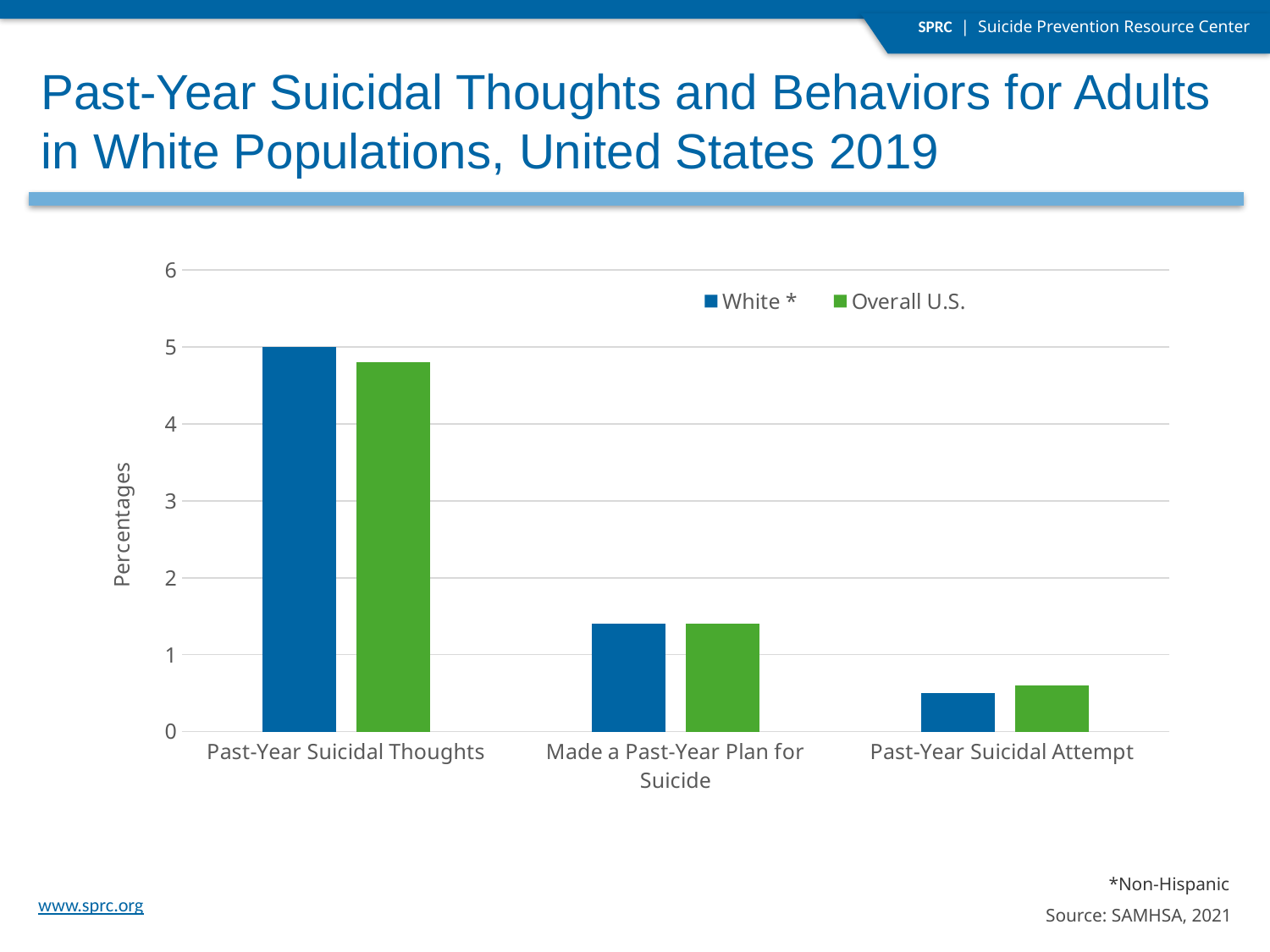
What is the label on the vertical axis? Percentages What is the White * value for Past-Year Suicidal Thoughts? 5 Is the White * value for Made a Past-Year Plan for Suicide greater or less than 2? less What kind of chart is shown on the slide? Bar chart Is the Overall U.S. value for Past-Year Suicidal Thoughts greater or less than 4? greater For Past-Year Suicidal Thoughts, which is larger: the White * value or the Overall U.S. value? White * Which category has the highest value for the White * series? Past-Year Suicidal Thoughts How many series does the legend list? 2 Do the White * values rise or fall moving from left to right across the categories? fall Is the Overall U.S. value for Past-Year Suicidal Attempt greater or less than 1? less How many categories are shown along the x axis? 3 Which category has the lowest value for the Overall U.S. series? Past-Year Suicidal Attempt